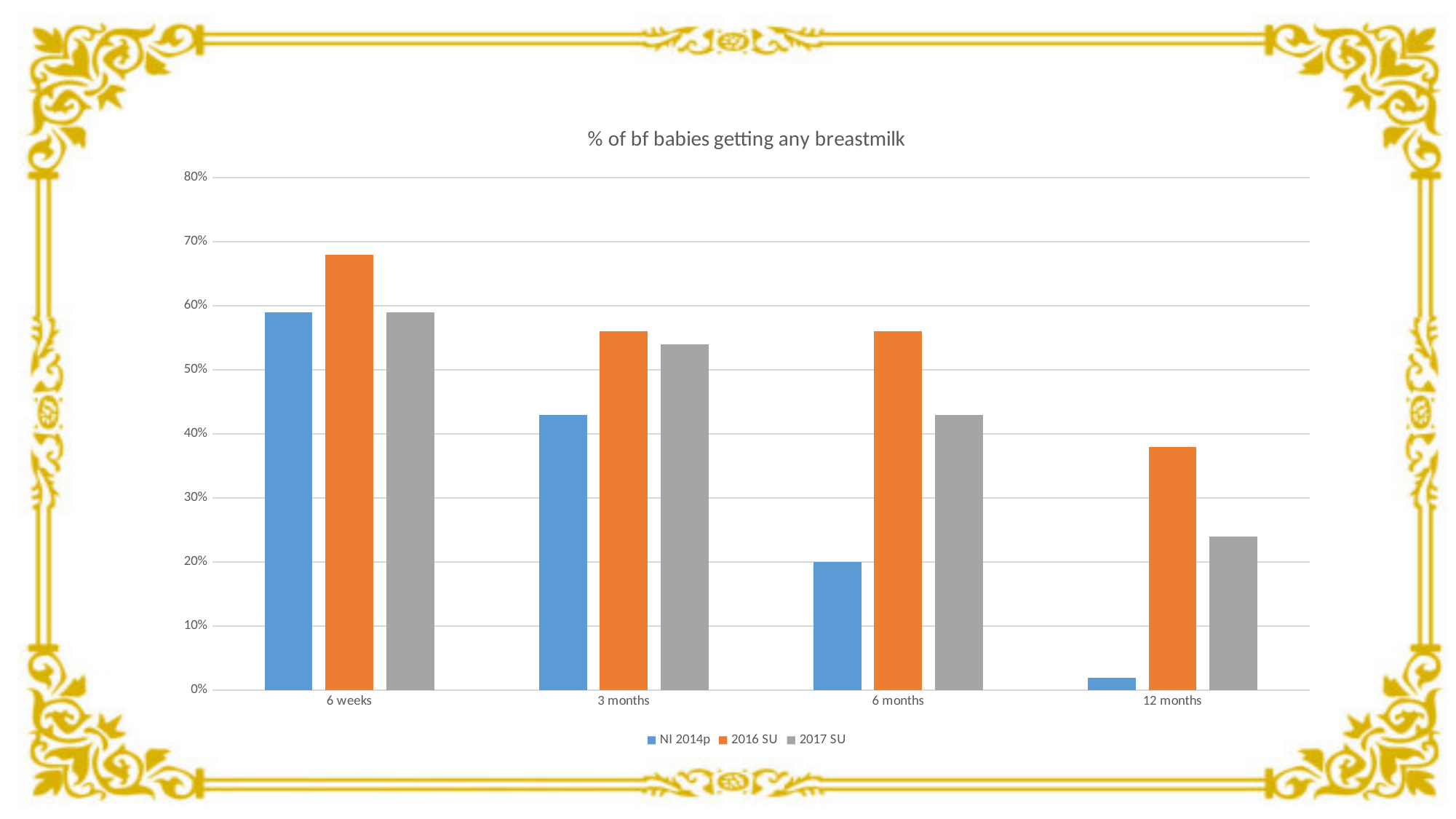
How many series does the legend list? 3 Is the value for 2016 SU at 12 months greater or less than 30%? greater What kind of chart is shown on the slide? bar chart Is the value for NI 2014p at 12 months greater or less than 10%? less What is the title of the chart? % of bf babies getting any breastmilk At 6 months, which is larger: 2016 SU or 2017 SU? 2016 SU Which series has the lowest value at 12 months? NI 2014p Do the NI 2014p values rise or fall from 6 weeks to 12 months? fall Is the value for 2016 SU at 6 weeks greater or less than 60%? greater Which series has the highest value at 6 weeks? 2016 SU How many categories are shown on the x axis? 4